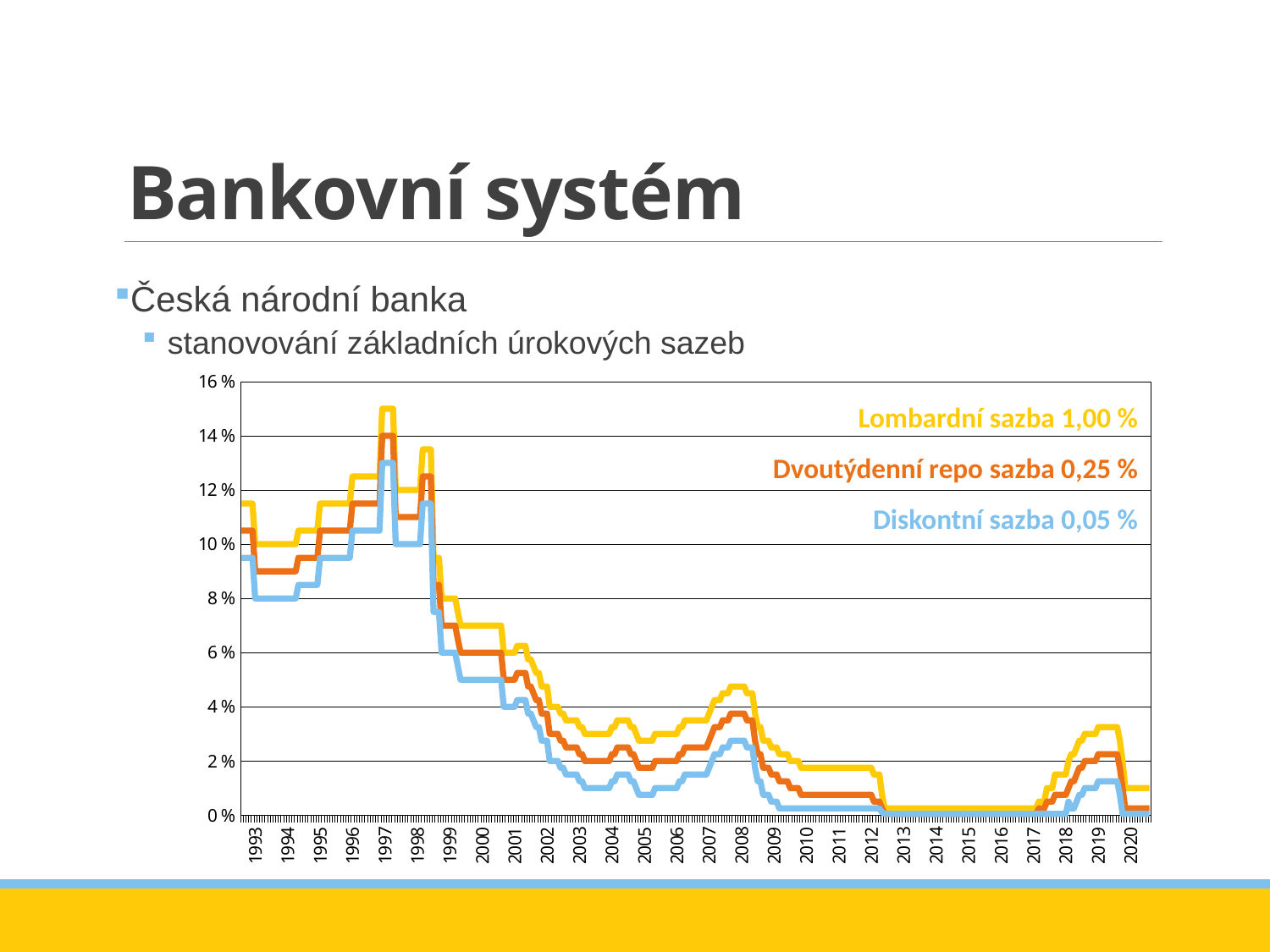
Is the value of the Diskontní sazba in 2015 greater or less than 2 %? less What value is shown for the Dvoutýdenní repo sazba in the chart label? 0,25 % Is the peak value of the Lombardní sazba around 1997 greater or less than 14 %? greater What value is shown for the Lombardní sazba in the chart label? 1,00 % How many series (rates) are plotted on the chart? 3 Which of the three rates has the highest labelled value? Lombardní sazba Which of the three rates has the lowest labelled value? Diskontní sazba In 2010, which is larger: the Lombardní sazba or the Diskontní sazba? Lombardní sazba Do the interest rates generally rise or fall between 1997 and 2013? fall What value is shown for the Diskontní sazba in the chart label? 0,05 % What kind of chart is shown on the slide? line chart What colour is the line for the Dvoutýdenní repo sazba? orange